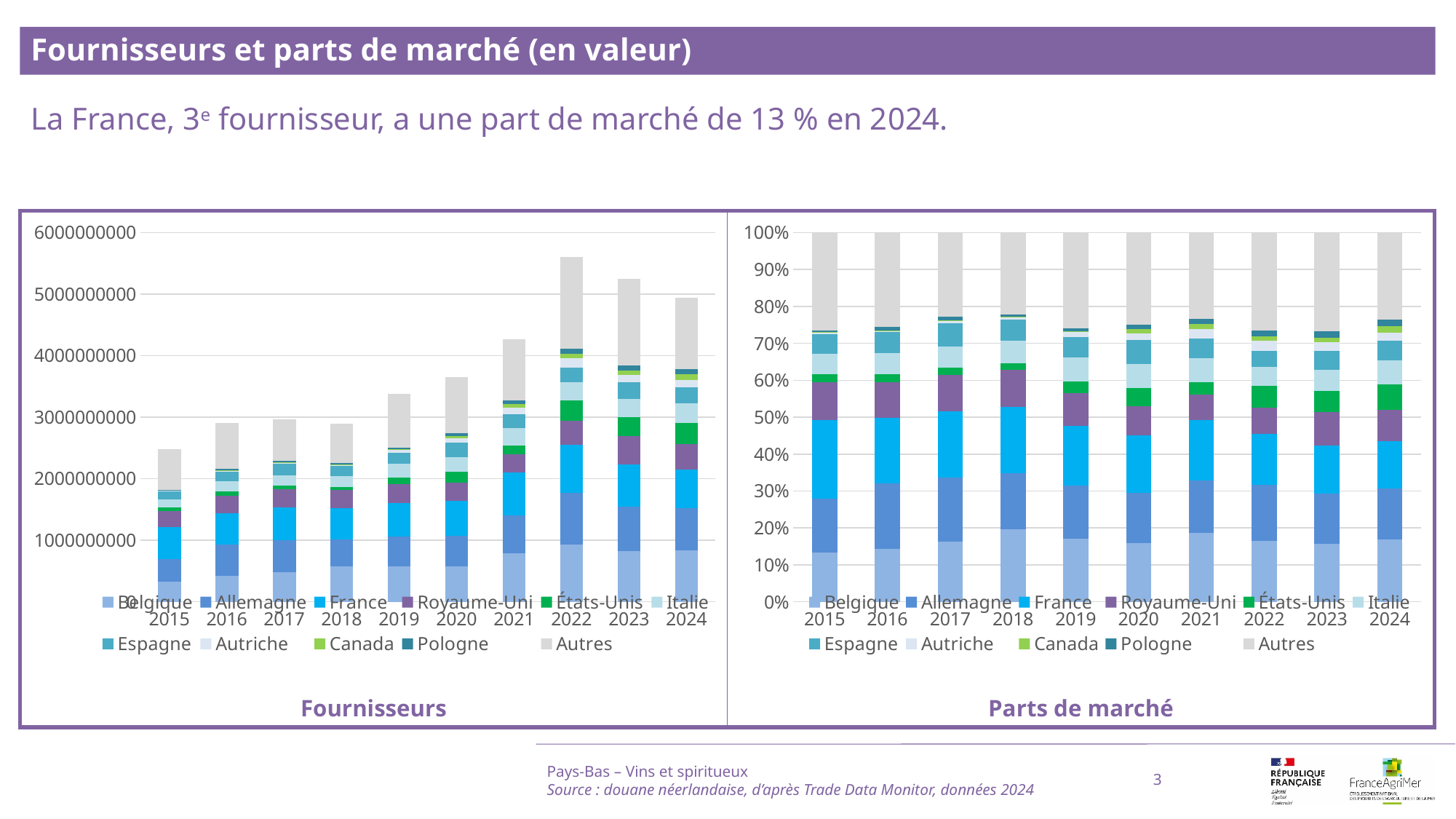
In the 'Fournisseurs' chart, is the total bar for 2022 greater or less than 5000000000? greater In the 'Fournisseurs' chart, which year has the tallest total bar? 2022 How many series does the legend of the 'Parts de marché' chart list? 11 In the 'Fournisseurs' chart, do the total bars generally rise or fall from 2015 to 2022? rise In the 'Fournisseurs' chart, is the total bar for 2015 greater or less than 3000000000? less In the 'Fournisseurs' chart, which total bar is taller, 2022 or 2023? 2022 Which series is shown in grey in the legend of the 'Fournisseurs' chart? Autres In the 'Fournisseurs' chart, which year has the shortest total bar? 2015 What kind of chart is the 'Fournisseurs' chart on the left? Stacked bar chart What is the title of the chart on the right? Parts de marché How many years are shown on the x axis of the 'Fournisseurs' chart? 10 In the 'Parts de marché' chart, is the Belgique share in 2024 greater or less than 10%? greater